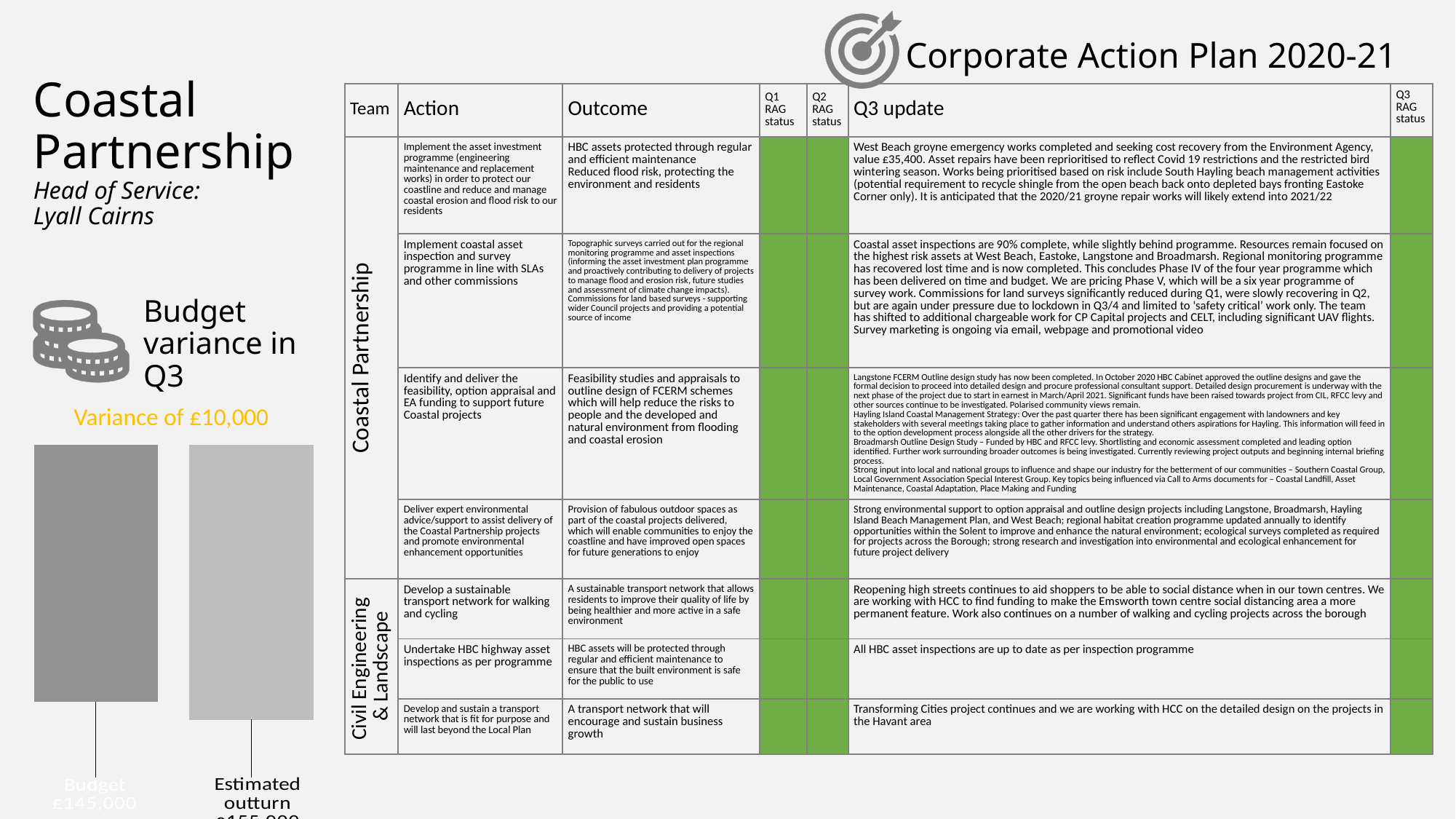
Which bar is taller on the 'Budget variance in Q3' chart, Budget or Estimated outturn? Estimated outturn What is the heading of the chart on the left of the slide? Budget variance in Q3 How many bars does the 'Budget variance in Q3' chart show? 2 What kind of chart is shown under the heading 'Budget variance in Q3'? bar chart What are the two categories labelled on the 'Budget variance in Q3' chart? Budget and Estimated outturn What variance is stated above the 'Budget variance in Q3' chart? £10,000 What is the Budget value shown on the 'Budget variance in Q3' chart? £145,000